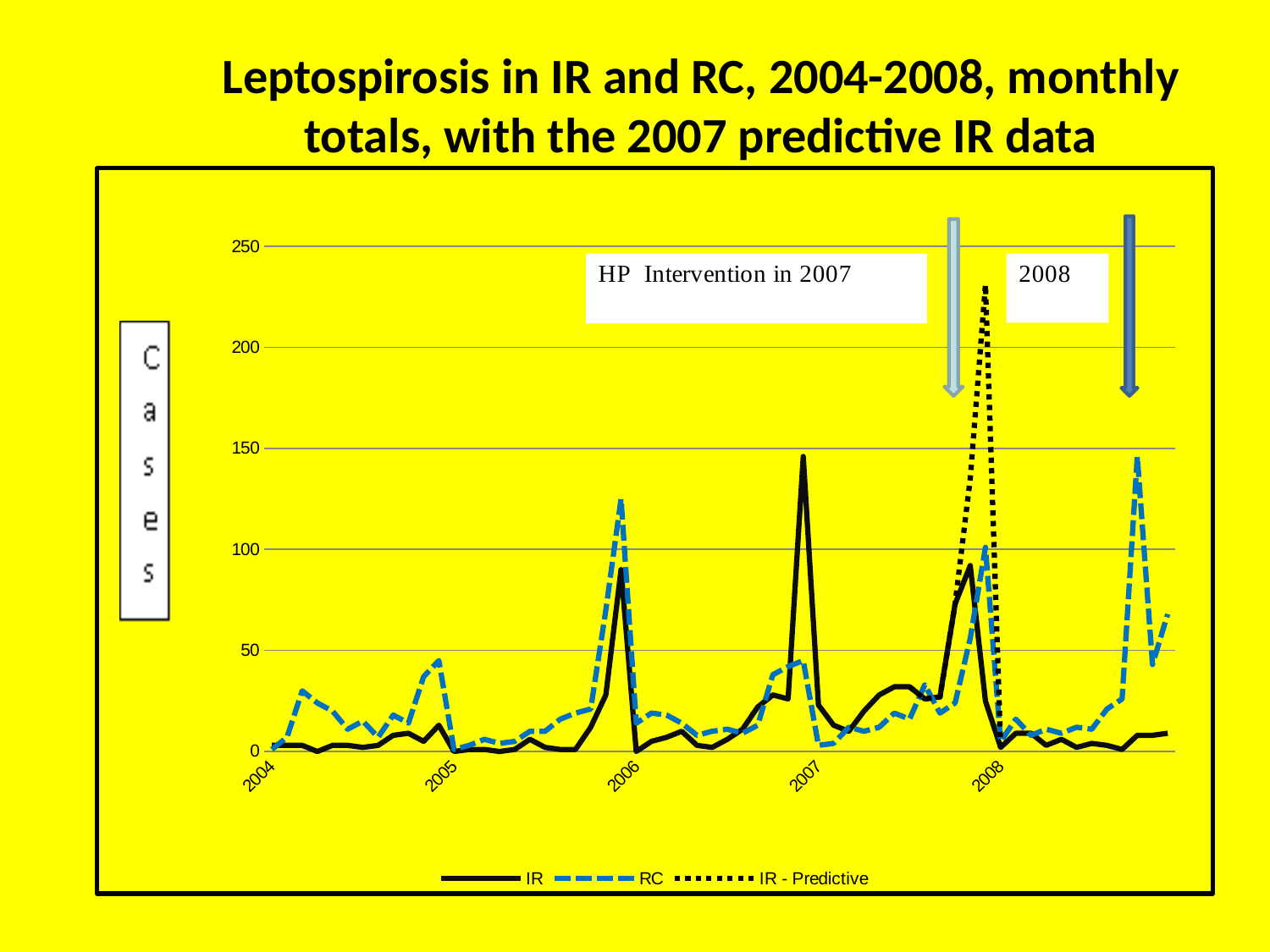
Which series reaches the highest peak on the chart? IR - Predictive Is the peak of the IR series near 2007 greater or less than 100? greater What are the three series named in the legend? IR, RC, IR - Predictive Which series has the higher peak near 2006, IR or RC? RC What kind of chart is shown on the slide? line chart Is the peak of the RC series near 2006 greater or less than 100? greater How many year labels are shown along the x axis? 5 Is the peak value of the IR - Predictive series greater or less than 200? greater What is the label on the vertical axis of the chart? Cases How many series does the legend list? 3